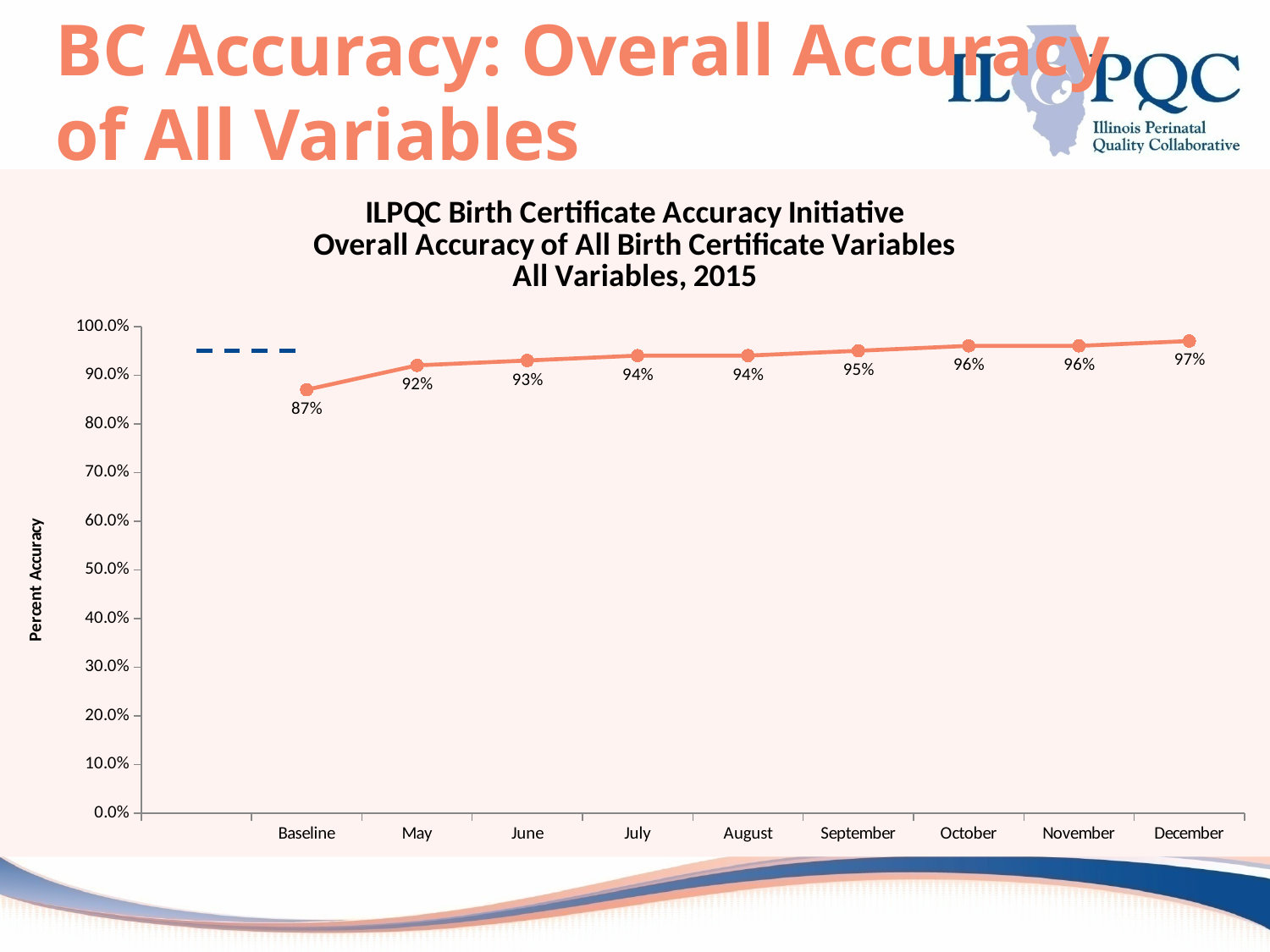
Is the value for Baseline greater or less than 90.0%? less What is the difference in percent accuracy between May and Baseline? 5% What is the difference in percent accuracy between December and Baseline? 10% What kind of chart is shown on the slide? Line chart Which point on the x axis has the lowest percent accuracy? Baseline How many data points are plotted on the line? 9 Do the percent accuracy values rise or fall from Baseline to December? Rise What is the percent accuracy for December? 97% What is the percent accuracy for September? 95% Which point on the x axis has the highest percent accuracy? December What is the percent accuracy at Baseline? 87% Which has a higher percent accuracy, June or October? October